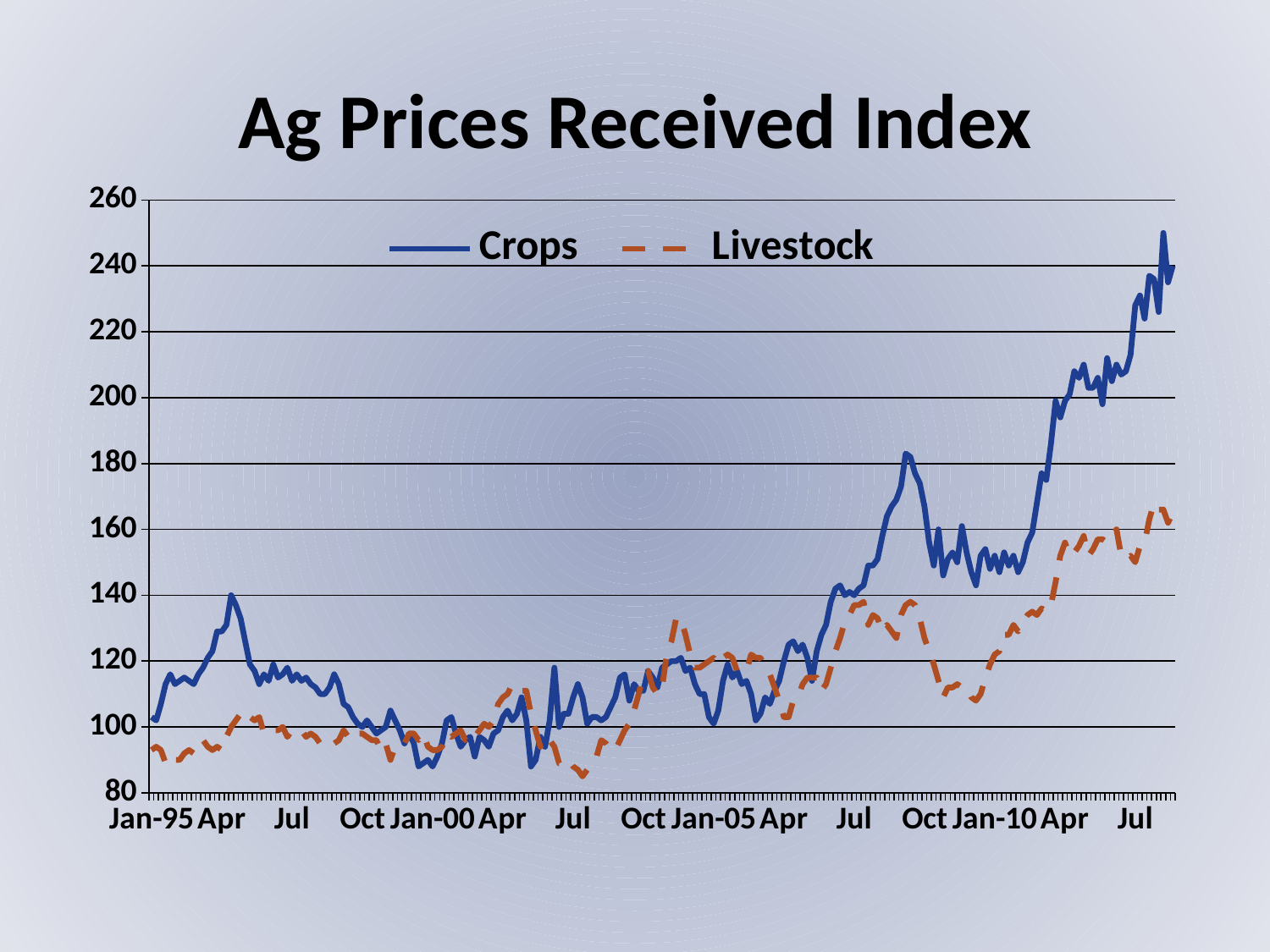
Is the Crops value at the right end of the chart greater or less than 220? greater How many series does the legend list? 2 At the right end of the chart, which series is higher, Crops or Livestock? Crops What kind of chart is shown on the slide? line chart Overall, do the Crops values rise or fall from Jan-95 to the end of the chart? rise Is the Livestock value at Jan-95 greater or less than 100? less What is the title of the chart? Ag Prices Received Index Which series is drawn with a dashed line? Livestock At Jan-95, which series is higher, Crops or Livestock? Crops Which series reaches the highest value on the chart? Crops